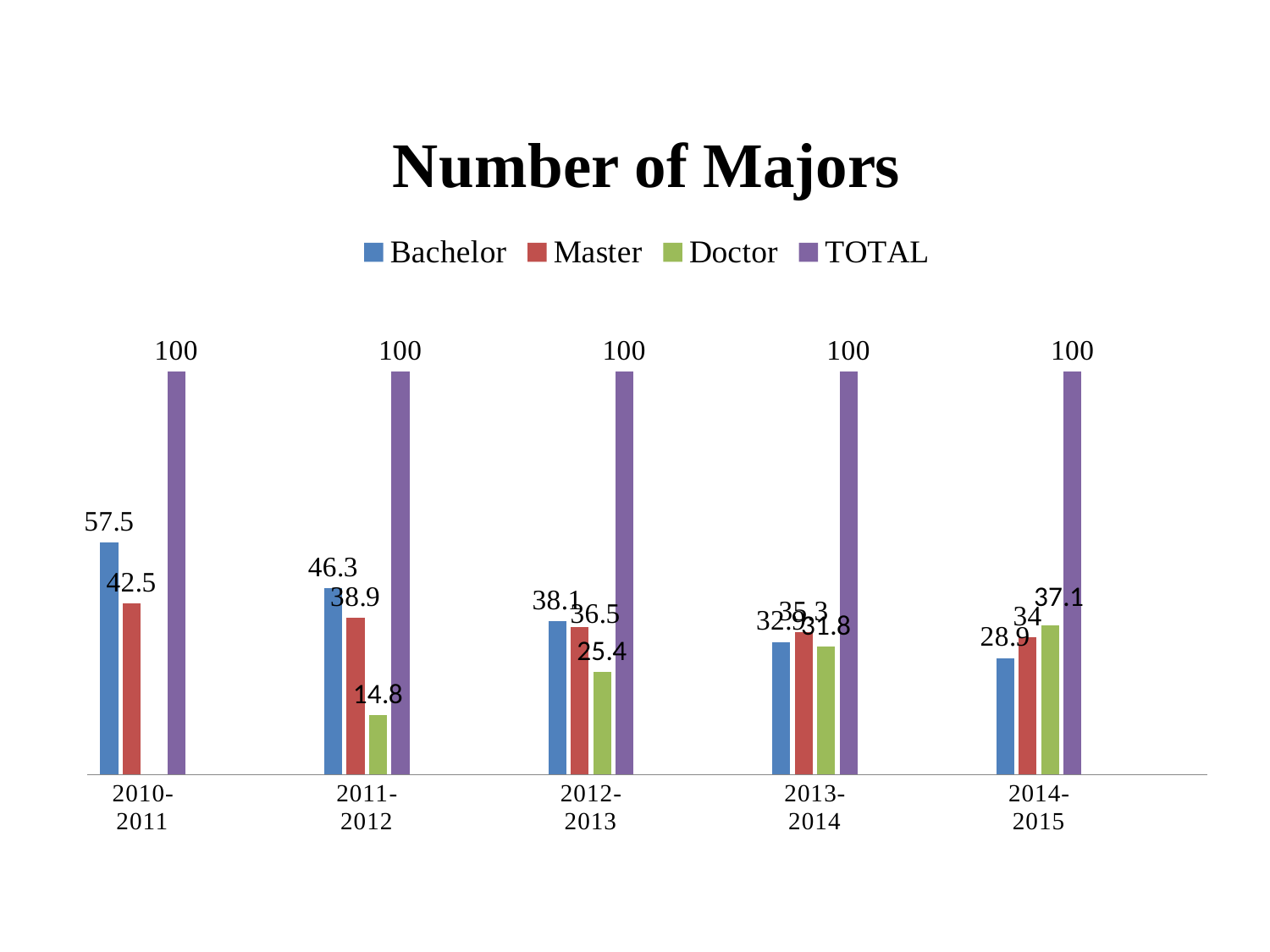
What is the value for Bachelor in 2010-2011? 57.5 How many series does the legend list? 4 In which year is the Bachelor value highest? 2010-2011 In which year is the Doctor value lowest? 2011-2012 What is the difference between the Bachelor and Master values in 2010-2011? 15 In 2014-2015, which is larger, Master or Doctor? Doctor What is the difference between the Bachelor and Doctor values in 2011-2012? 31.5 What is the value for Master in 2012-2013? 36.5 What is the value for Doctor in 2011-2012? 14.8 How many year categories are shown on the x axis? 5 Does the Bachelor value rise or fall from 2010-2011 to 2014-2015? fall What is the value for Doctor in 2014-2015? 37.1